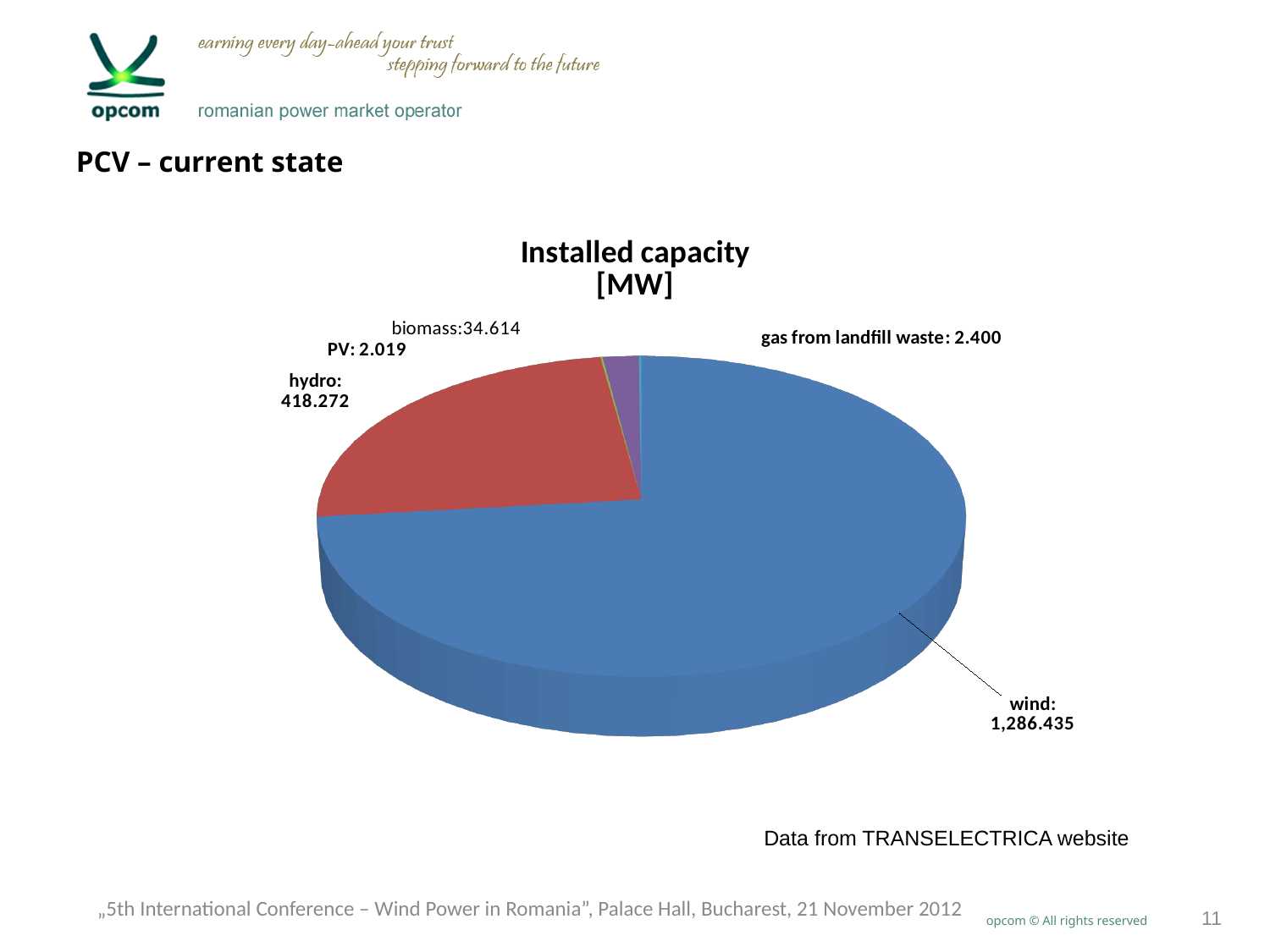
Which has a larger installed capacity, PV or gas from landfill waste? gas from landfill waste Which source has the largest installed capacity? wind How many sources are shown in the pie chart? 5 What is the title of the chart? Installed capacity [MW] What is the installed capacity for hydro? 418.272 What is the installed capacity for PV? 2.019 What is the installed capacity for gas from landfill waste? 2.400 What is the difference in installed capacity between wind and hydro? 868.163 What is the installed capacity for wind? 1,286.435 What is the installed capacity for biomass? 34.614 Which source has the smallest installed capacity? PV What kind of chart is shown on the slide? pie chart